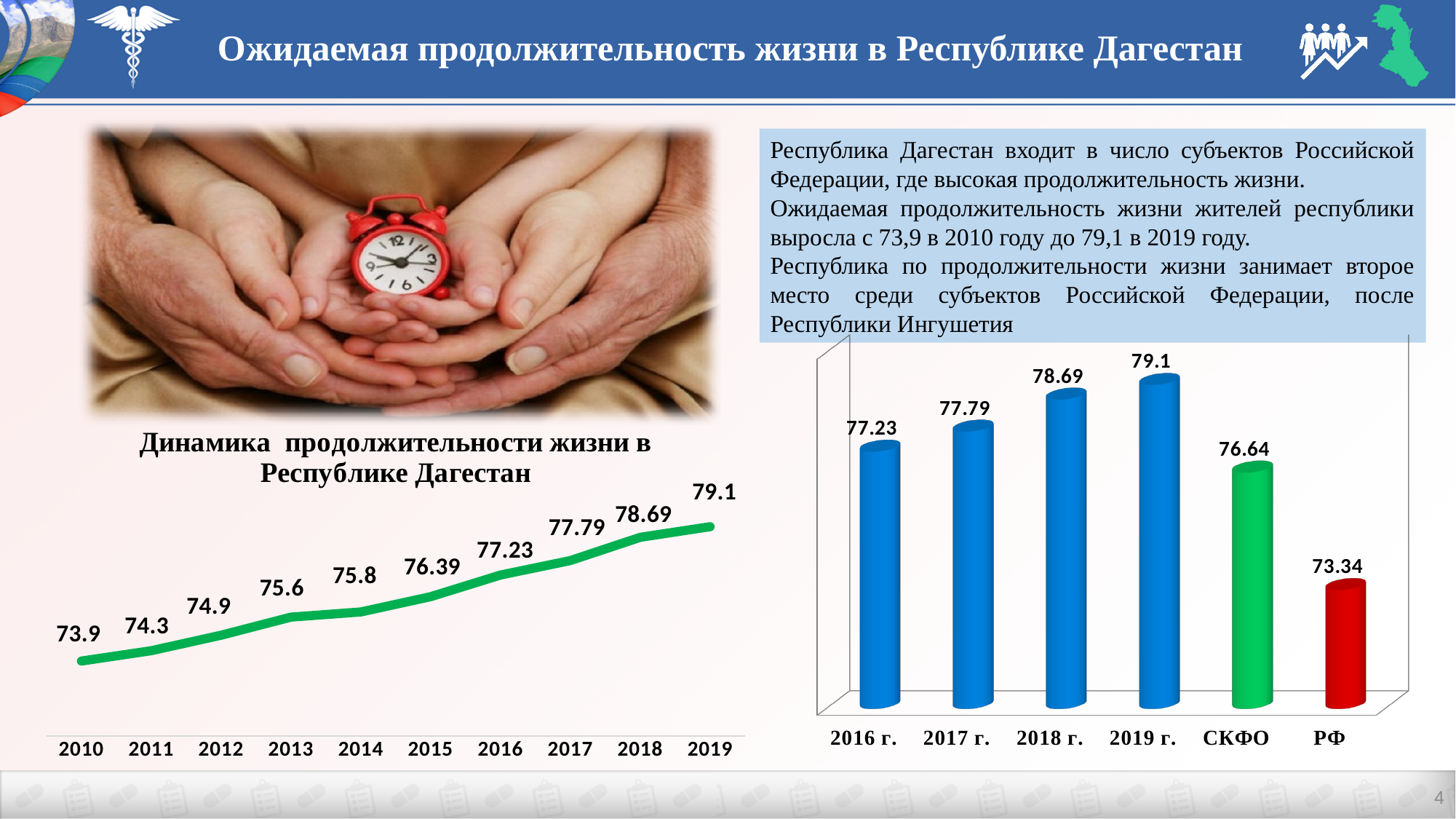
In the bar chart on the right, which is larger: the value for 2019 г. or the value for СКФО? 2019 г. In the line chart on the left, how many years are plotted? 10 In the bar chart on the right, what is the value for СКФО? 76.64 In the line chart on the left, which year has the lowest value? 2010 In the line chart on the left, do the values rise or fall from 2010 to 2019? rise In the bar chart on the right, what is the value for РФ? 73.34 What kind of chart is the chart on the right side of the slide? bar chart In the line chart 'Динамика продолжительности жизни в Республике Дагестан', what is the value for 2015? 76.39 In the line chart on the left, which year has the highest value? 2019 In the line chart on the left, what is the difference between the values for 2019 and 2010? 5.2 In the line chart 'Динамика продолжительности жизни в Республике Дагестан', what is the value for 2010? 73.9 In the bar chart on the right, which category has the lowest value? РФ